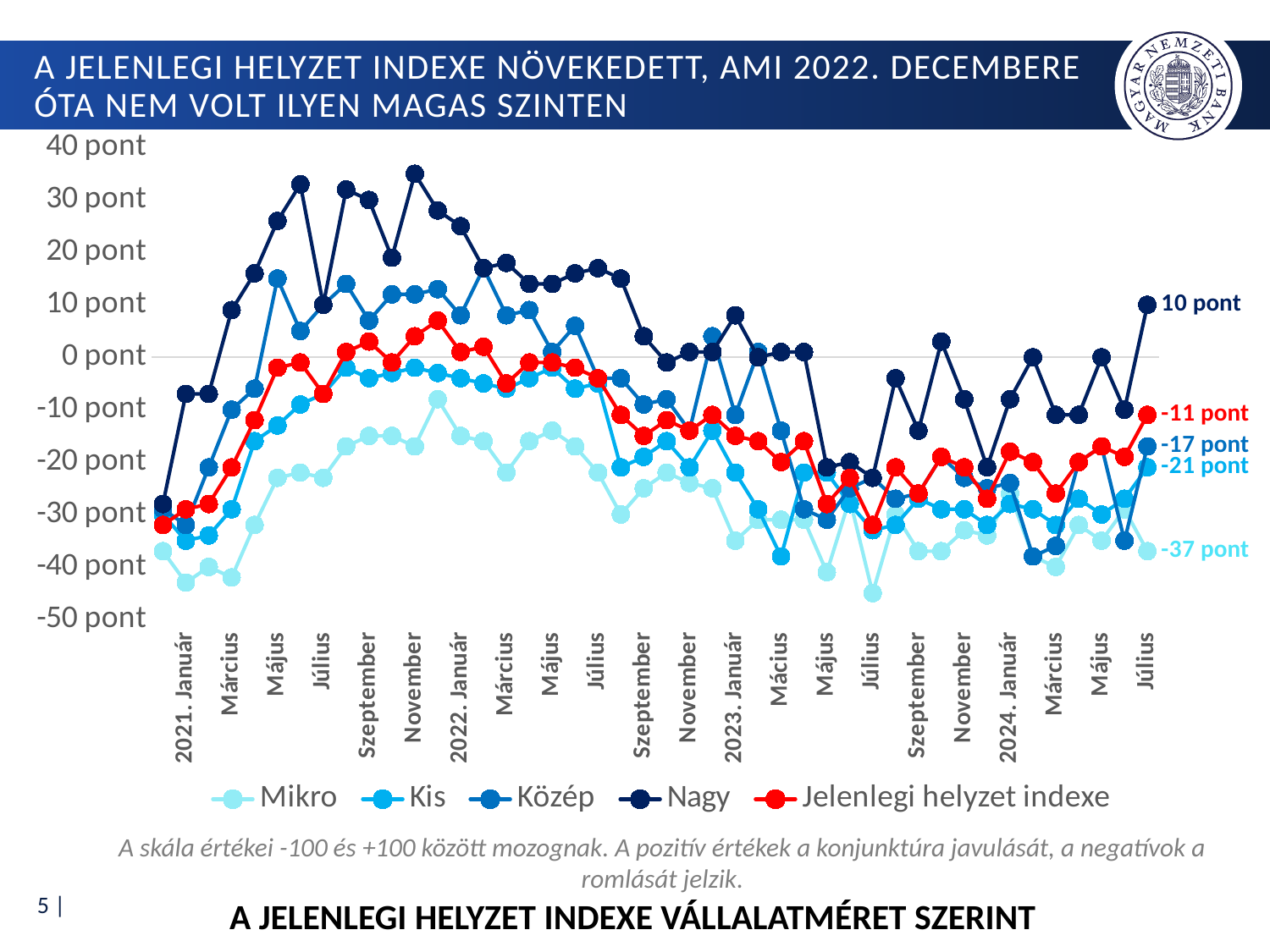
What is the value of the Mikro series at the last point (2024 Július)? -37 pont Which series has the lowest value at the last point (2024 Július)? Mikro How many series does the legend list? 5 What kind of chart is shown on the slide? Line chart What is the difference between the Nagy and Mikro values at the last point (2024 Július)? 47 pont Is the value of the Nagy series at 2021 Május greater or less than 20 pont? greater What is the difference between the Közép and Kis values at the last point (2024 Július)? 4 pont What is the value of the Kis series at the last point (2024 Július)? -21 pont What is the title of the chart shown at the bottom of the slide? A JELENLEGI HELYZET INDEXE VÁLLALATMÉRET SZERINT What is the value of the Jelenlegi helyzet indexe series at the last point (2024 Július)? -11 pont Which series has the highest value at the last point (2024 Július)? Nagy What is the value of the Nagy series at the last point (2024 Július)? 10 pont